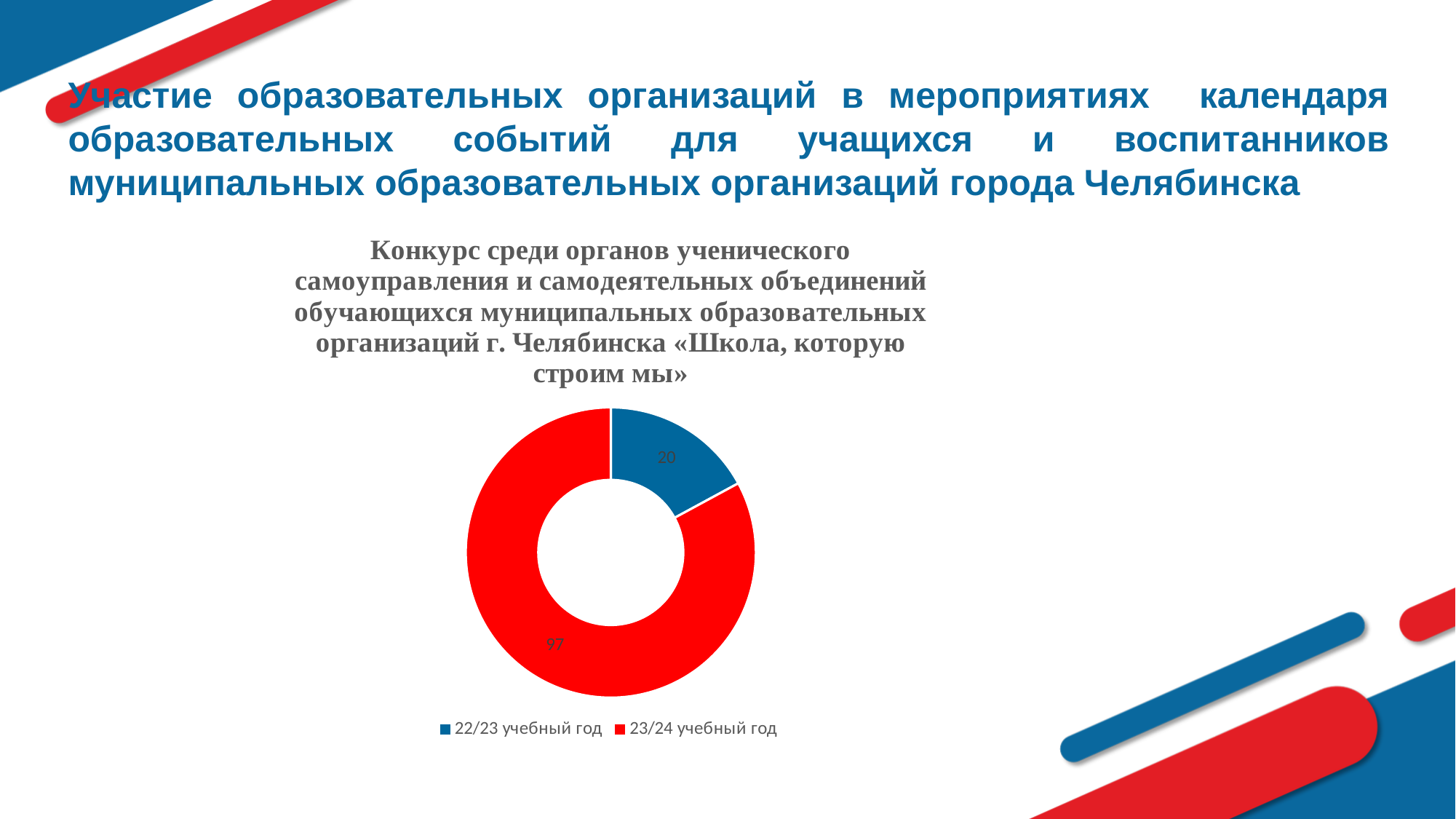
Which academic year has the larger value in the chart? 23/24 учебный год What is the difference between the values for 23/24 учебный год and 22/23 учебный год? 77 What kind of chart is shown on the slide? Doughnut (pie) chart How many slices does the chart have? 2 Is the value for 22/23 учебный год larger or smaller than the value for 23/24 учебный год? smaller What colour is the slice for 22/23 учебный год? Blue What is the value for 22/23 учебный год in the doughnut chart? 20 How many entries does the legend list? 2 Which academic year has the smaller value in the chart? 22/23 учебный год What is the value for 23/24 учебный год in the doughnut chart? 97 What colour is the slice for 23/24 учебный год? Red What is the total of the two values shown in the chart? 117